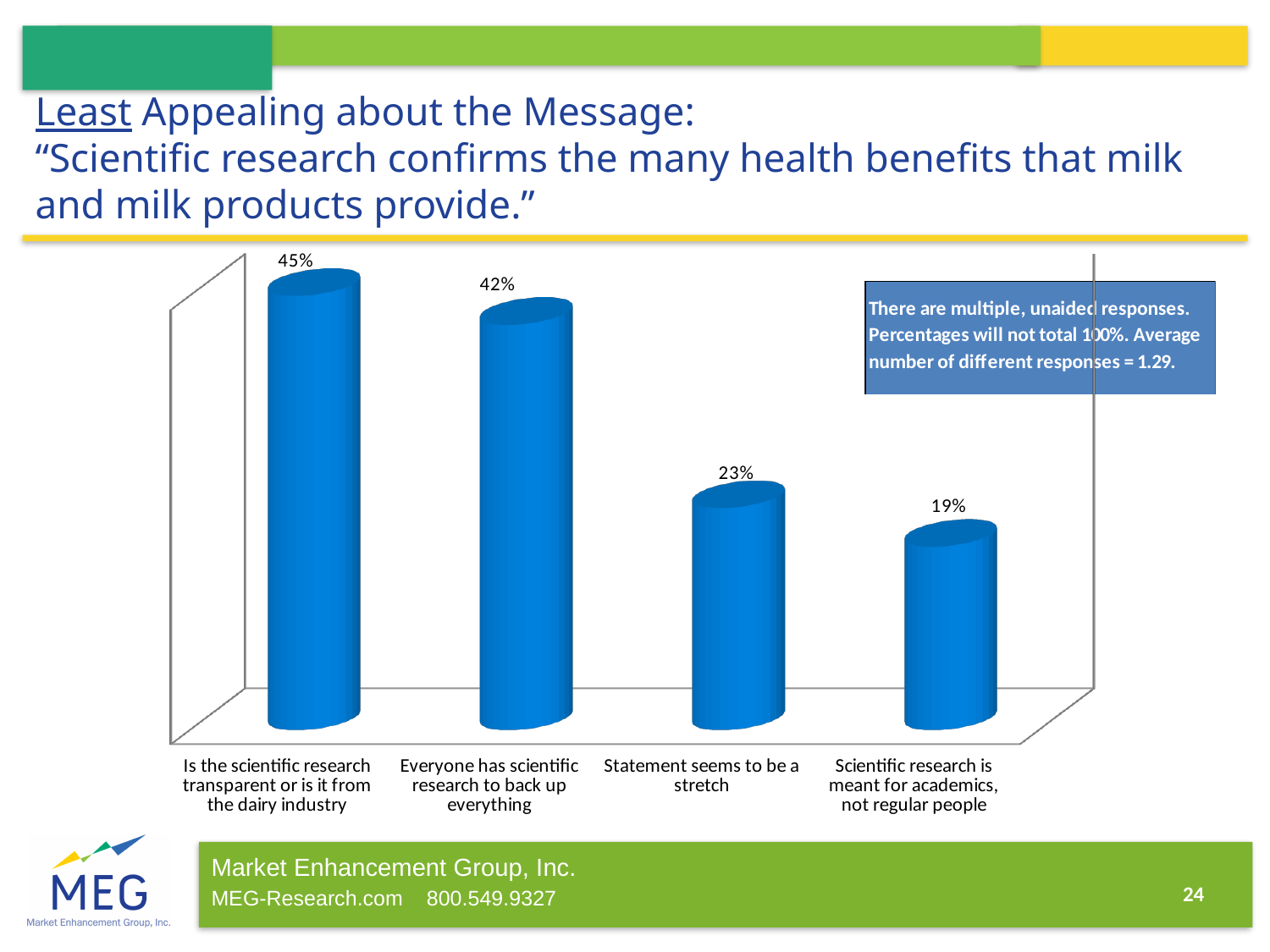
What is the difference between the values for "Statement seems to be a stretch" and "Scientific research is meant for academics, not regular people"? 4% What is the value for "Scientific research is meant for academics, not regular people"? 19% According to the note on the chart, what is the average number of different responses? 1.29 What percentage of respondents said "Is the scientific research transparent or is it from the dairy industry"? 45% What is the difference between the values for "Is the scientific research transparent or is it from the dairy industry" and "Everyone has scientific research to back up everything"? 3% What is the value for "Everyone has scientific research to back up everything"? 42% What kind of chart is shown on the slide? Bar chart Which response has the highest percentage? Is the scientific research transparent or is it from the dairy industry Which response has the lowest percentage? Scientific research is meant for academics, not regular people What is the value for "Statement seems to be a stretch"? 23% How many response categories are shown in the chart? 4 Which is larger: the value for "Everyone has scientific research to back up everything" or "Statement seems to be a stretch"? Everyone has scientific research to back up everything